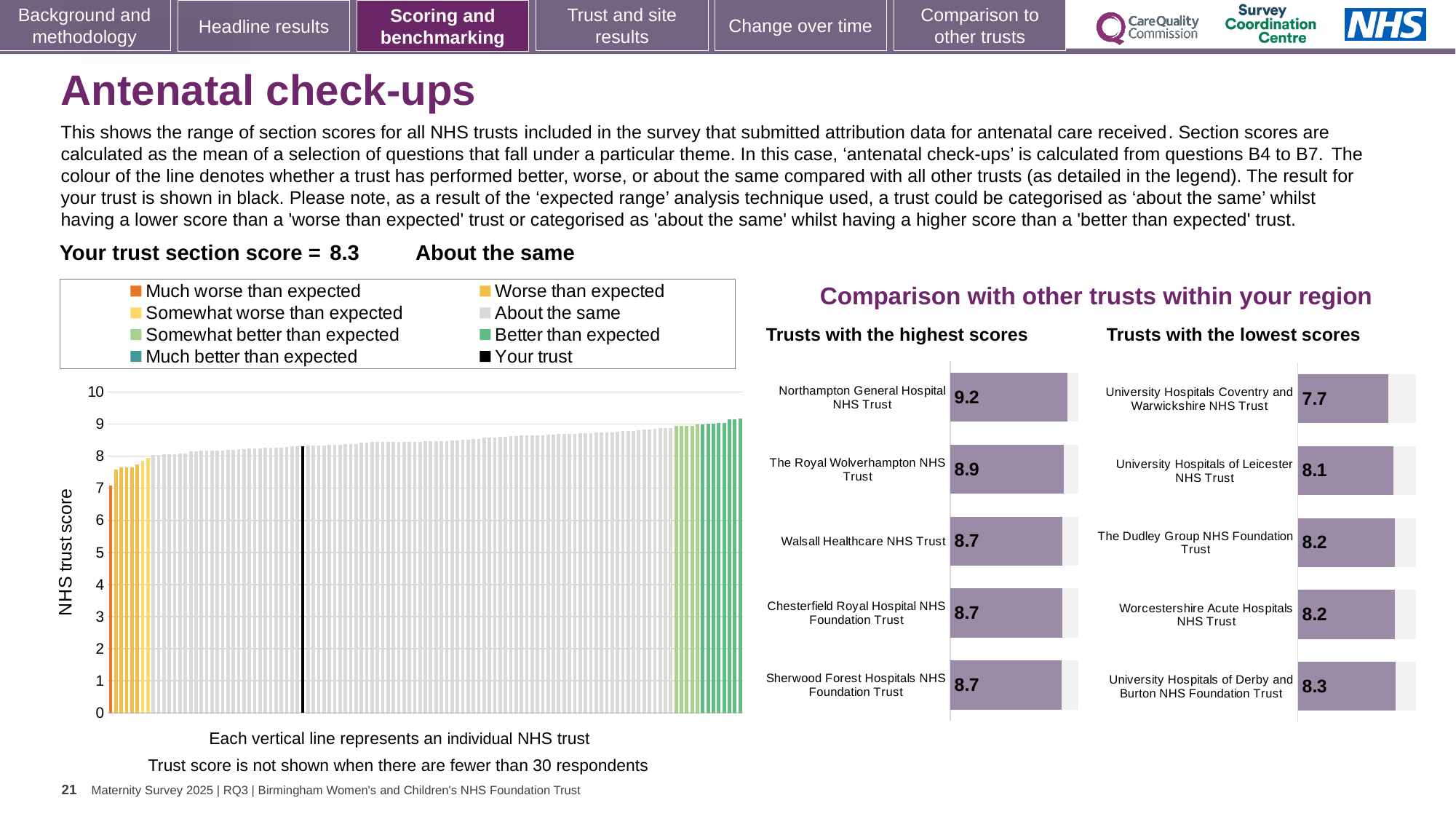
In the 'Trusts with the highest scores' chart, what is the difference between the scores of Northampton General Hospital NHS Trust and The Royal Wolverhampton NHS Trust? 0.3 In the large chart on the left, what is the label on the vertical axis? NHS trust score In the 'Trusts with the highest scores' chart, which trust has the highest score? Northampton General Hospital NHS Trust In the large chart on the left, do the bar values rise or fall from left to right along the x axis? rise How many trusts are shown in the 'Trusts with the highest scores' chart? 5 In the 'Trusts with the lowest scores' chart, which trust has the lowest score? University Hospitals Coventry and Warwickshire NHS Trust In the 'Trusts with the highest scores' chart, what is the score for Northampton General Hospital NHS Trust? 9.2 In the 'Trusts with the lowest scores' chart, what is the score for University Hospitals of Derby and Burton NHS Foundation Trust? 8.3 In the 'Trusts with the lowest scores' chart, which has the larger score: University Hospitals of Leicester NHS Trust or The Dudley Group NHS Foundation Trust? The Dudley Group NHS Foundation Trust In the large chart on the left, is the value for the black bar (your trust) greater or less than 8? greater What kind of chart is the large chart on the left showing NHS trust scores? bar chart How many entries does the legend above the large chart on the left list? 8